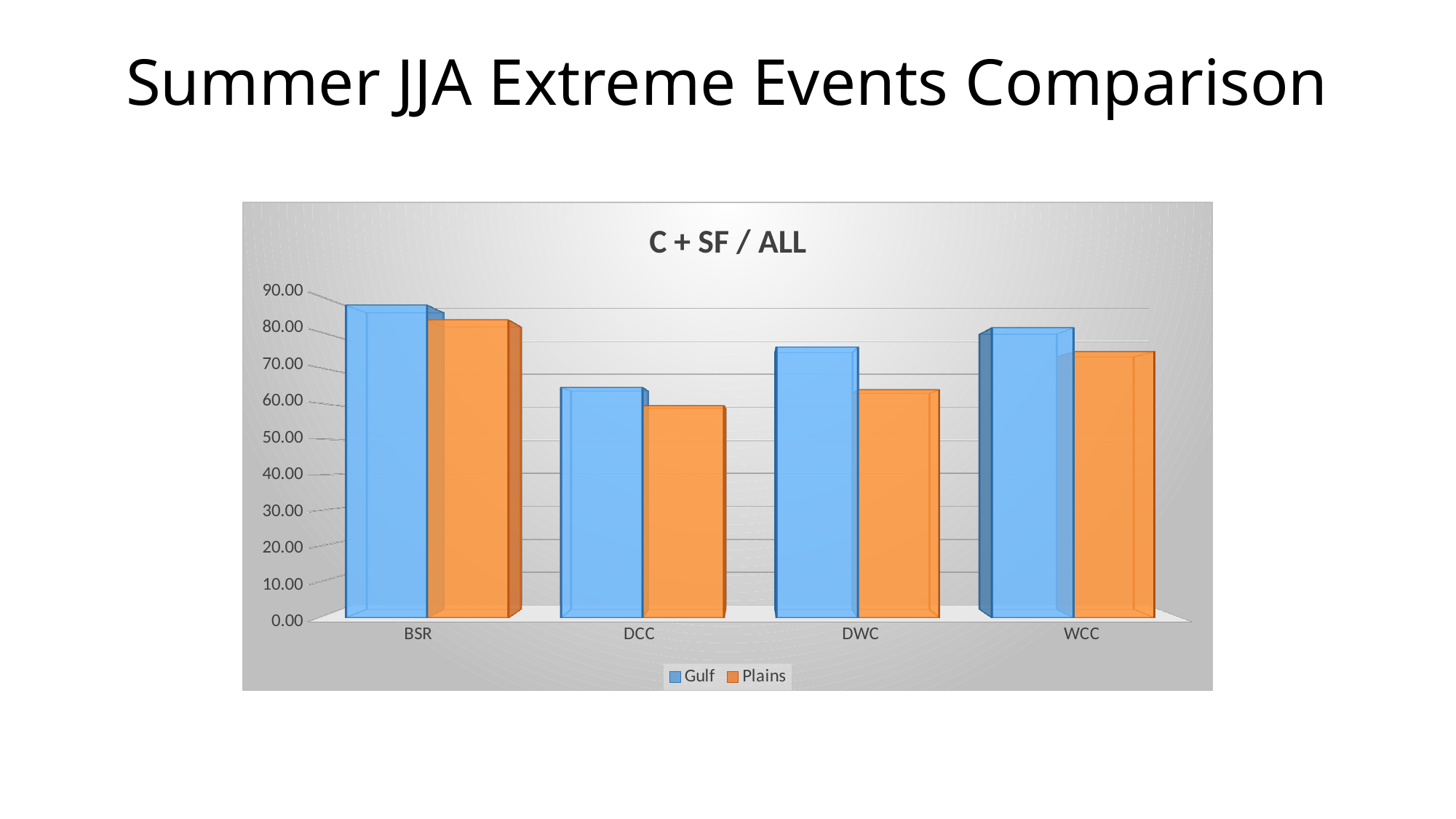
How many categories are shown on the x axis? 4 Is the Plains value for DCC greater or less than 70.00? less For DWC, which series has the larger value, Gulf or Plains? Gulf Is the Gulf value for DWC greater or less than 70.00? greater What kind of chart is shown on the slide? bar chart Which category has the lowest Gulf value? DCC Which series is shown in orange? Plains What is the title of the chart? C + SF / ALL How many series does the legend list? 2 Which category has the lowest Plains value? DCC Is the Gulf value for BSR greater or less than 80.00? greater Which category has the highest Gulf value? BSR